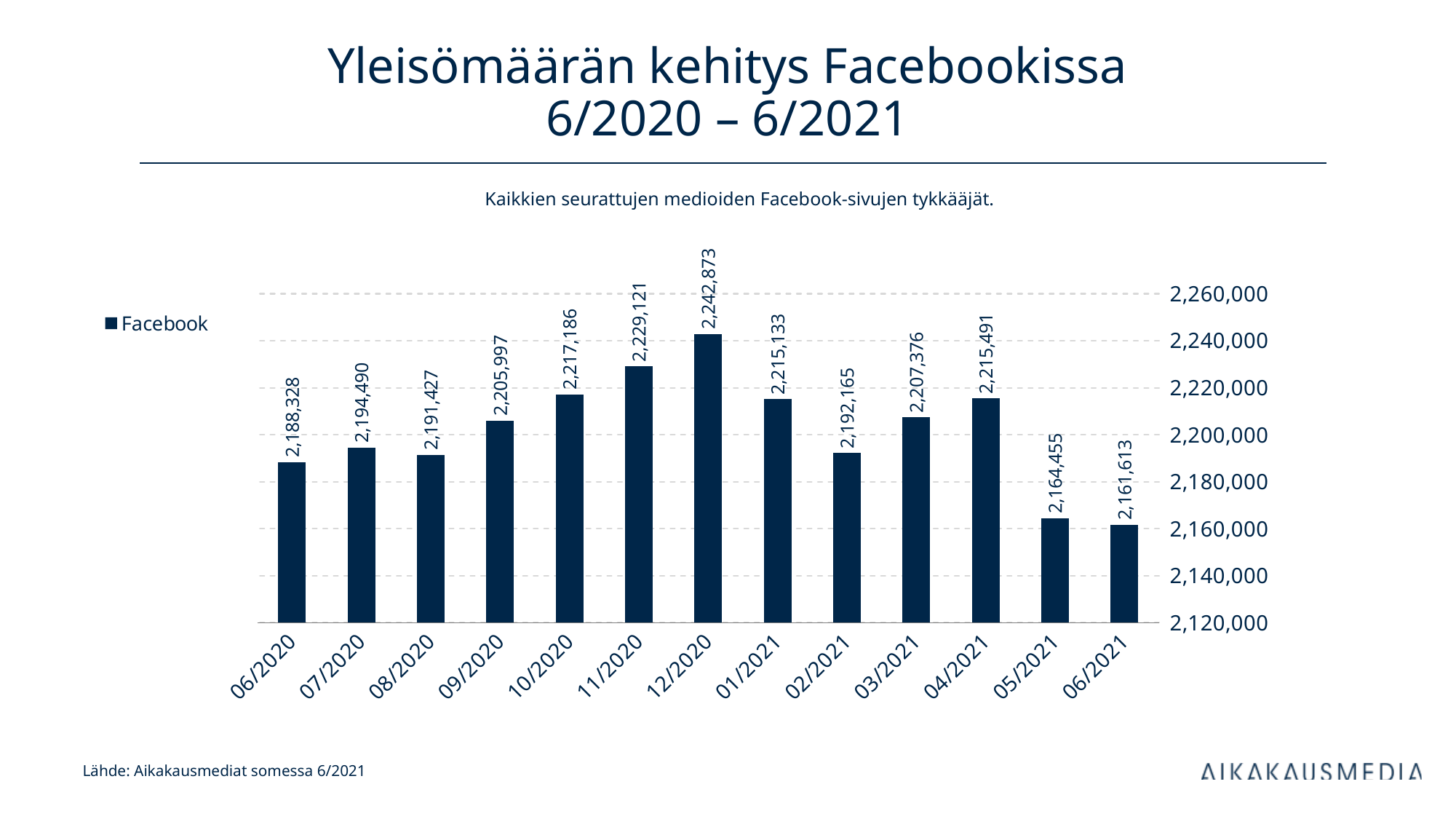
What is the value for 06/2021? 2,161,613 What is the value for 12/2020? 2,242,873 What kind of chart is shown on the slide? bar chart What is the value for 09/2020? 2,205,997 Which month has the highest value? 12/2020 What is the difference between the values for 12/2020 and 06/2020? 54,545 Which month has the lowest value? 06/2021 What is the difference between the values for 06/2020 and 06/2021? 26,715 Is the value for 05/2021 greater or less than 2,180,000? less Which is larger, the value for 10/2020 or the value for 01/2021? 10/2020 How many months are shown on the x axis? 13 How many series does the legend list? 1